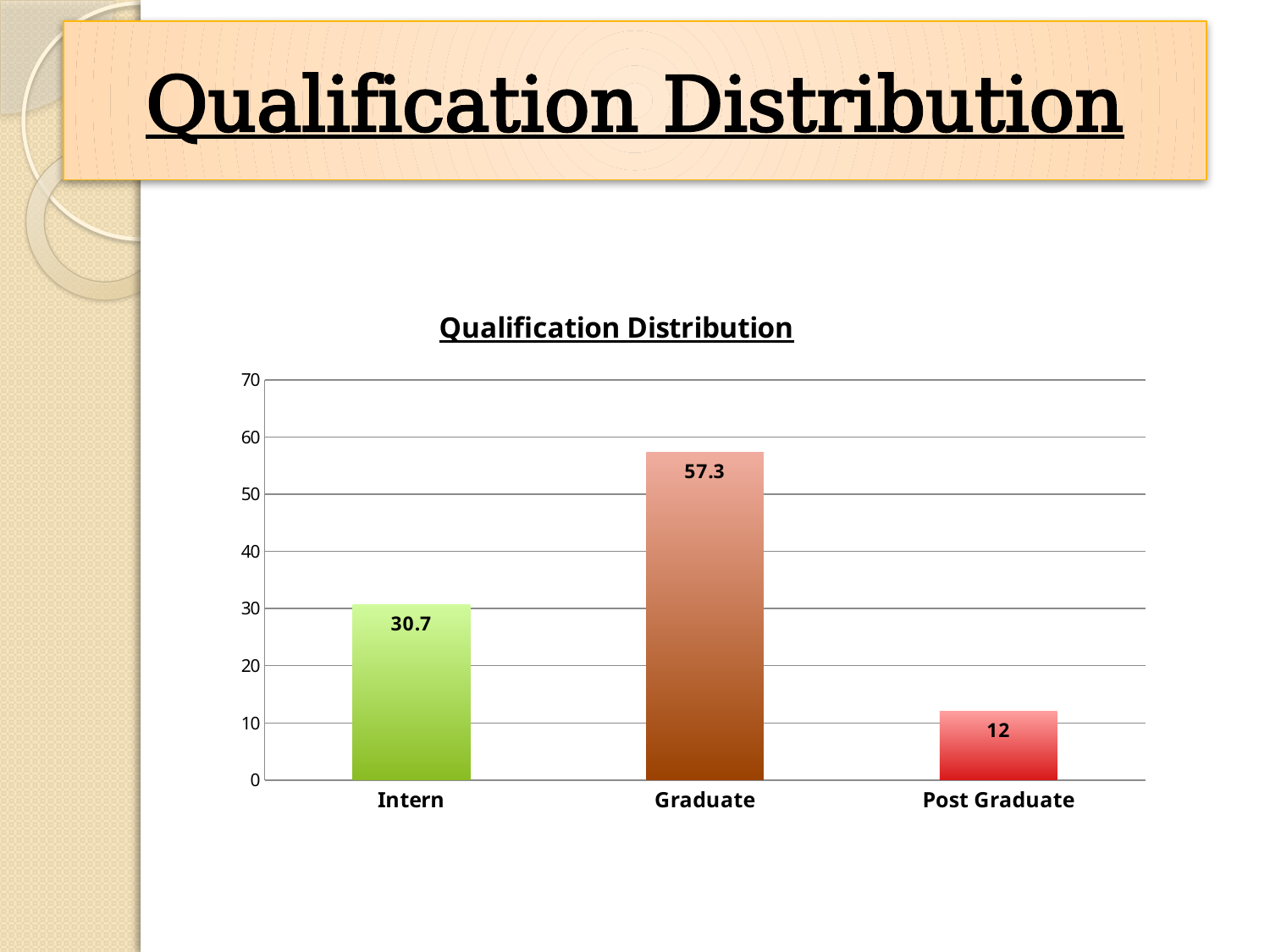
Is the value for Graduate greater or less than 50? greater Which category has the highest value? Graduate Which category has the lowest value? Post Graduate What is the difference between the values for Graduate and Intern? 26.6 What is the value for Intern? 30.7 How many categories are shown on the x axis? 3 What is the value for Post Graduate? 12 What is the value for Graduate? 57.3 Which is larger, the value for Intern or the value for Post Graduate? Intern What is the title of the chart? Qualification Distribution What kind of chart is shown on the slide? bar chart What is the difference between the values for Intern and Post Graduate? 18.7